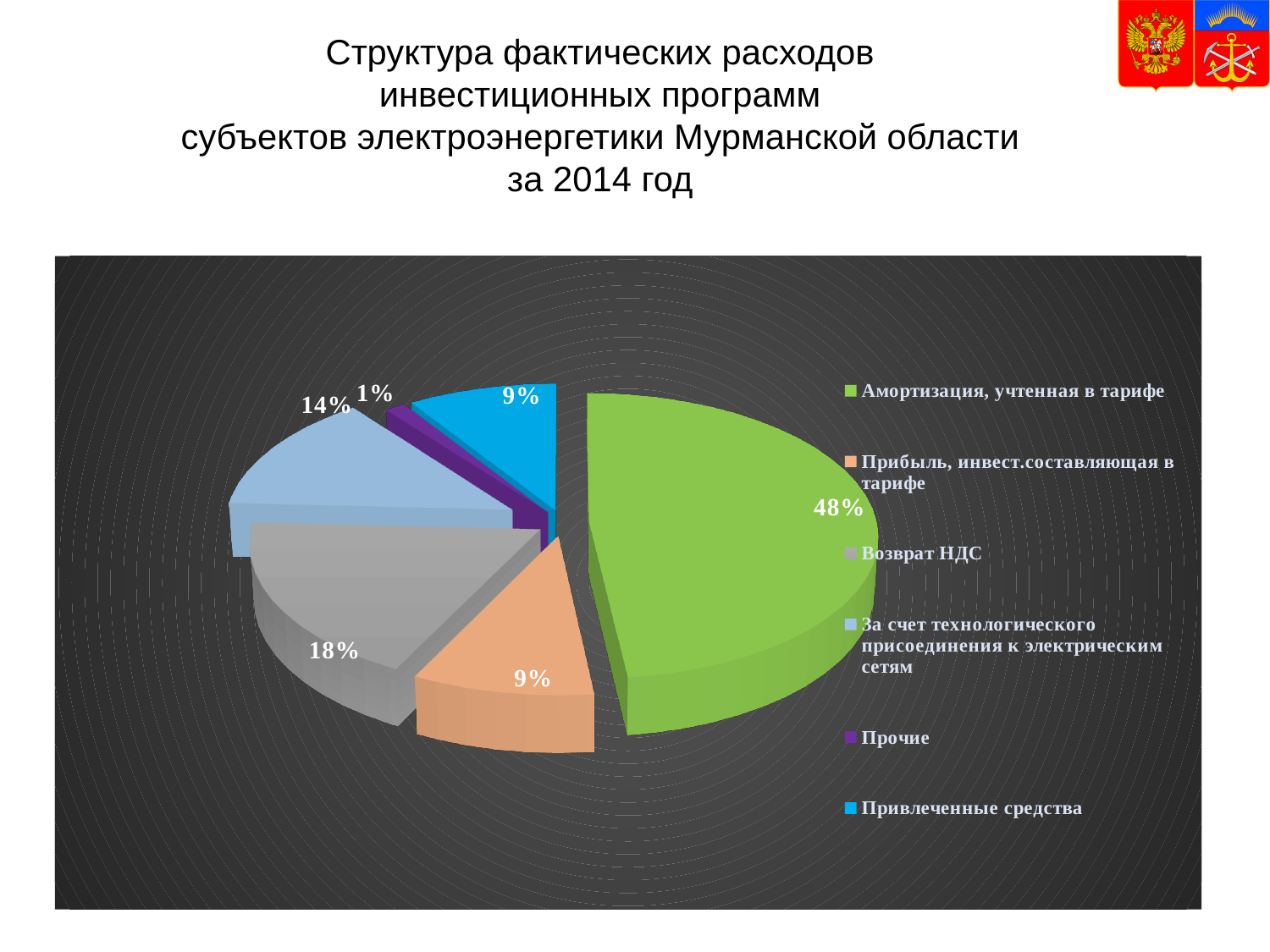
What colour is the slice for "Прочие"? Purple Which is larger: the share for "Возврат НДС" or the share for "За счет технологического присоединения к электрическим сетям"? Возврат НДС Which category has the smallest slice of the pie? Прочие What share of the pie does "За счет технологического присоединения к электрическим сетям" represent? 14% What share of the pie does "Амортизация, учтенная в тарифе" represent? 48% What share of the pie does "Возврат НДС" represent? 18% What is the difference in percentage points between "Амортизация, учтенная в тарифе" and "Возврат НДС"? 30 What type of chart is shown on the slide? Pie chart How many categories does the legend list? 6 Which category has the largest slice of the pie? Амортизация, учтенная в тарифе